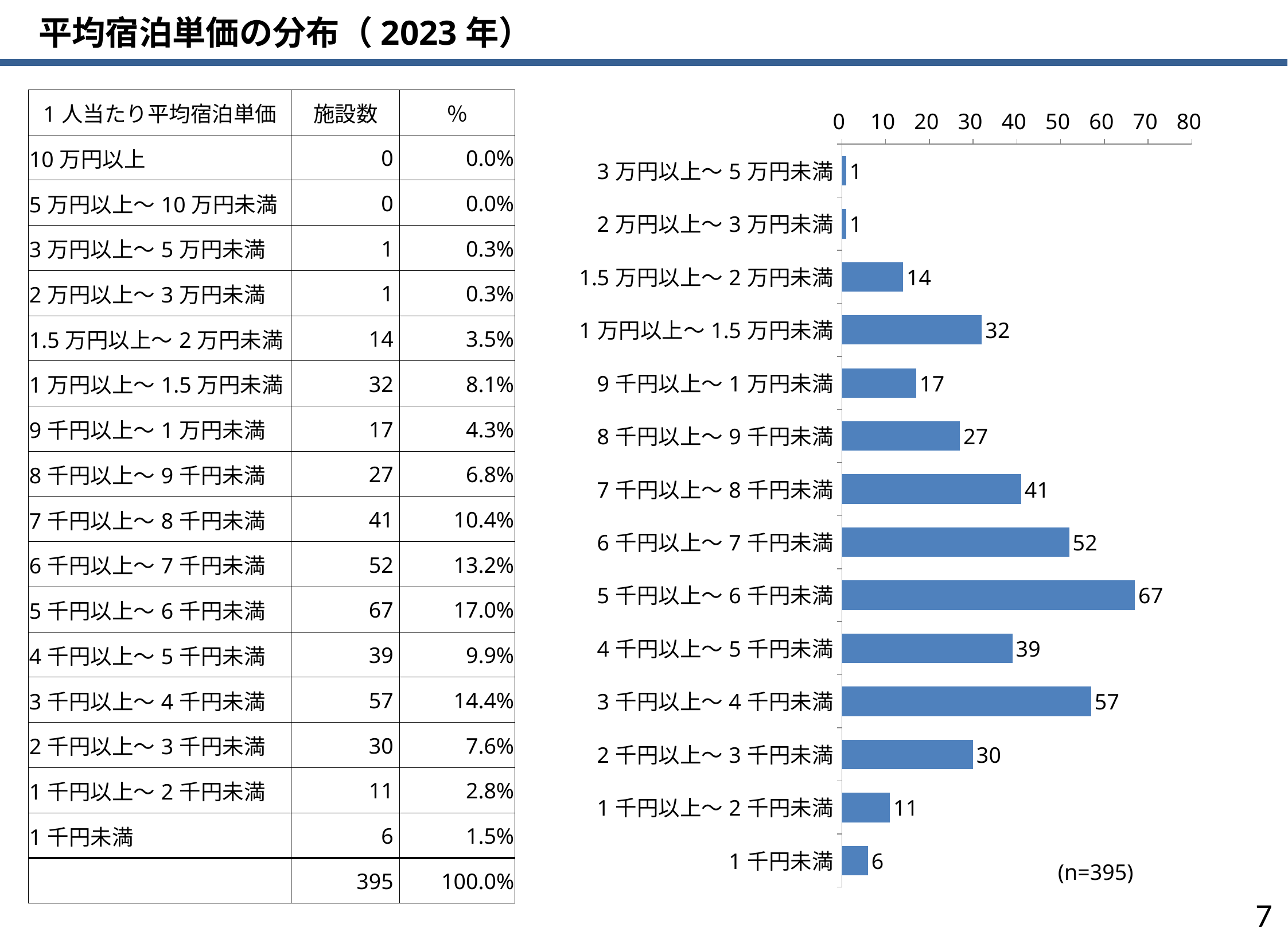
What is the value for 1.5万円以上～2万円未満 in the bar chart? 14 What is the value for 5千円以上～6千円未満 in the bar chart? 67 What is the difference between the values for 5千円以上～6千円未満 and 3千円以上～4千円未満? 10 What is the value for 1千円未満 in the bar chart? 6 Which is larger in the bar chart: 7千円以上～8千円未満 or 4千円以上～5千円未満? 7千円以上～8千円未満 What kind of chart is shown on the slide? bar chart Is the value for 6千円以上～7千円未満 greater or less than 50? greater What is the difference between the values for 1万円以上～1.5万円未満 and 9千円以上～1万円未満? 15 What is the sample size (n) noted on the bar chart? n=395 How many categories are shown in the bar chart? 14 Which category has the highest value in the bar chart? 5千円以上～6千円未満 What is the title of the slide? 平均宿泊単価の分布（2023年）